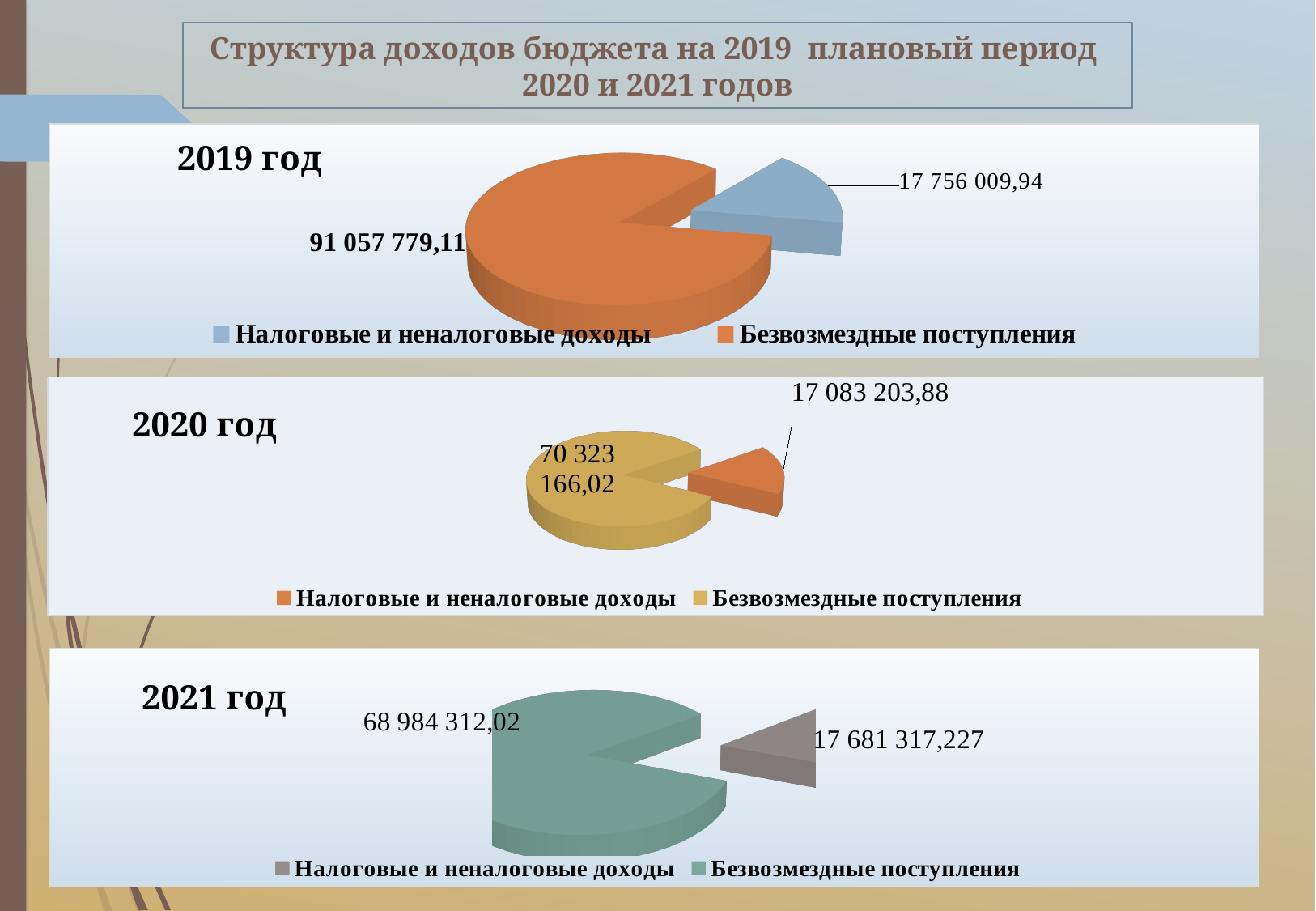
How many series does the legend of the 2021 год chart list? 2 In the 2020 год chart, what is the value for Безвозмездные поступления? 70 323 166,02 What kind of chart is used for the 2020 год data? Pie chart In the 2021 год chart, what is the value for Налоговые и неналоговые доходы? 17 681 317,227 In the 2020 год chart, what is the difference between Безвозмездные поступления and Налоговые и неналоговые доходы? 53 239 962,14 In the 2019 год chart, what is the value for Налоговые и неналоговые доходы? 17 756 009,94 In the 2019 год chart, which category has the largest slice? Безвозмездные поступления In the 2019 год chart, what is the value for Безвозмездные поступления? 91 057 779,11 In the 2021 год chart, which category has the smallest slice? Налоговые и неналоговые доходы In the 2020 год chart, what is the value for Налоговые и неналоговые доходы? 17 083 203,88 In the 2019 год chart, what is the difference between Безвозмездные поступления and Налоговые и неналоговые доходы? 73 301 769,17 In the 2021 год chart, what is the value for Безвозмездные поступления? 68 984 312,02